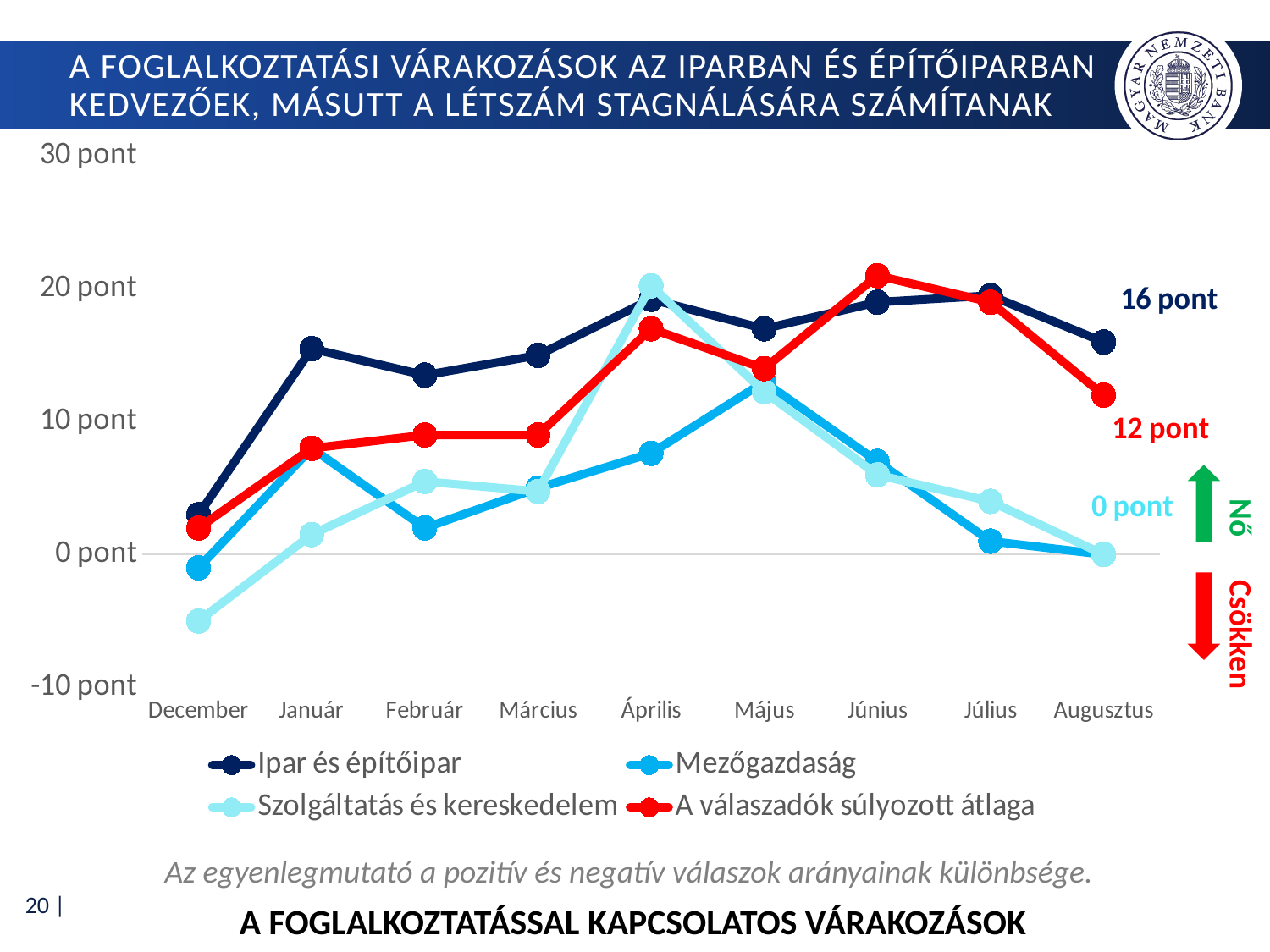
What is the value for A válaszadók súlyozott átlaga in Augusztus? 12 pont What kind of chart is shown on the slide? Line chart How many series does the legend list? 4 In which month is Szolgáltatás és kereskedelem at its lowest? December Does the Mezőgazdaság series rise or fall from Május to Augusztus? Falls Which series has the highest value in Június? A válaszadók súlyozott átlaga What is the value for Szolgáltatás és kereskedelem in Augusztus? 0 pont Is the value for Szolgáltatás és kereskedelem in Április greater or less than 10 pont? greater What is the value for Ipar és építőipar in Augusztus? 16 pont Is the value for Ipar és építőipar in December greater or less than 10 pont? less How many months are shown on the x axis? 9 What is the difference between the Augusztus values of Ipar és építőipar and A válaszadók súlyozott átlaga? 4 pont